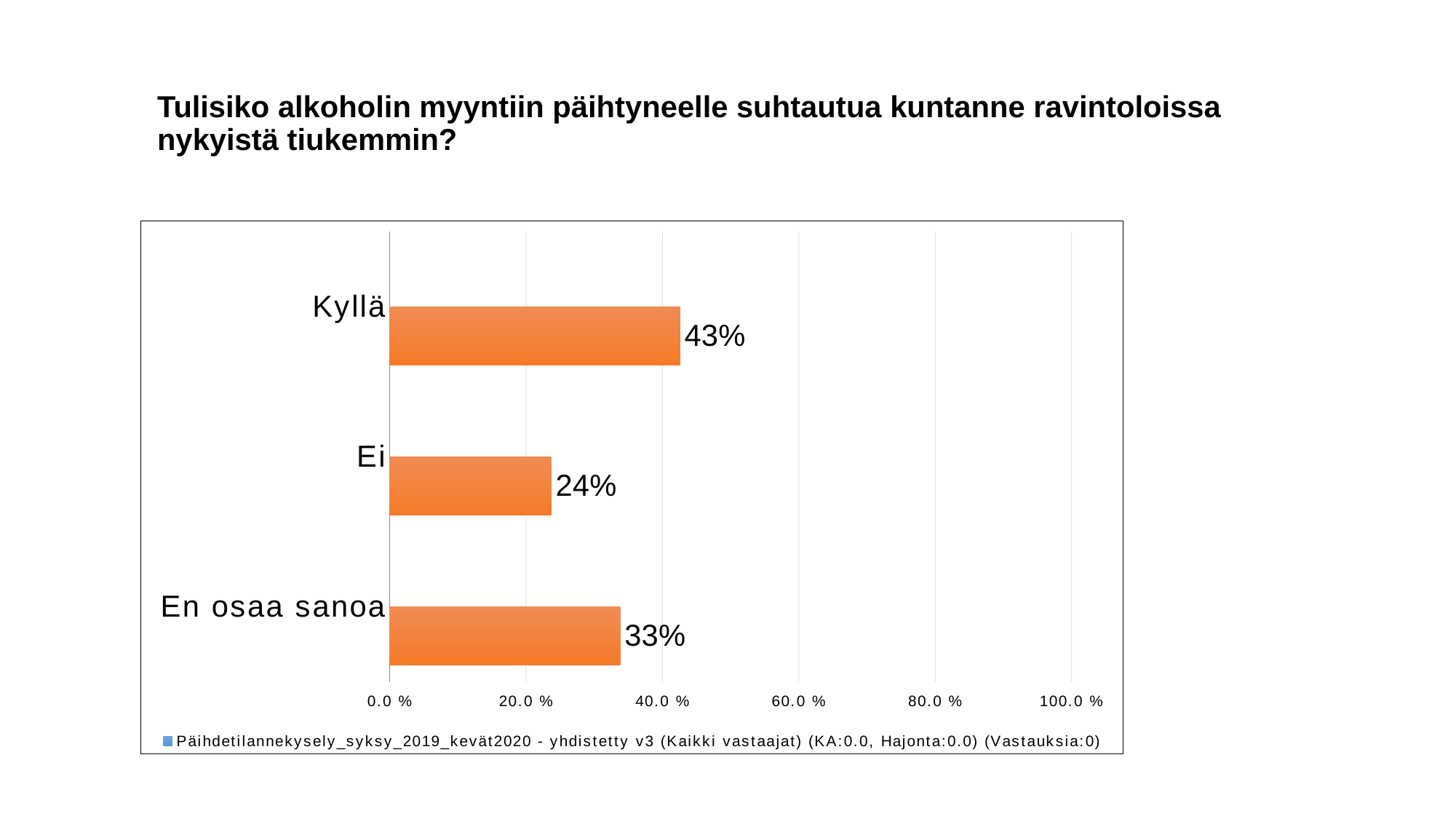
What is the difference between the values for En osaa sanoa and Ei? 9% Which is larger, the value for En osaa sanoa or the value for Ei? En osaa sanoa What is the value for En osaa sanoa? 33% What kind of chart is shown on the slide? bar chart Is the value for Kyllä greater or less than 40.0 %? greater What is the value for Ei? 24% What is the difference between the values for Kyllä and Ei? 19% How many categories are shown in the chart? 3 What is the title of the slide? Tulisiko alkoholin myyntiin päihtyneelle suhtautua kuntanne ravintoloissa nykyistä tiukemmin? Which category has the highest value? Kyllä Which category has the lowest value? Ei What is the value for Kyllä? 43%